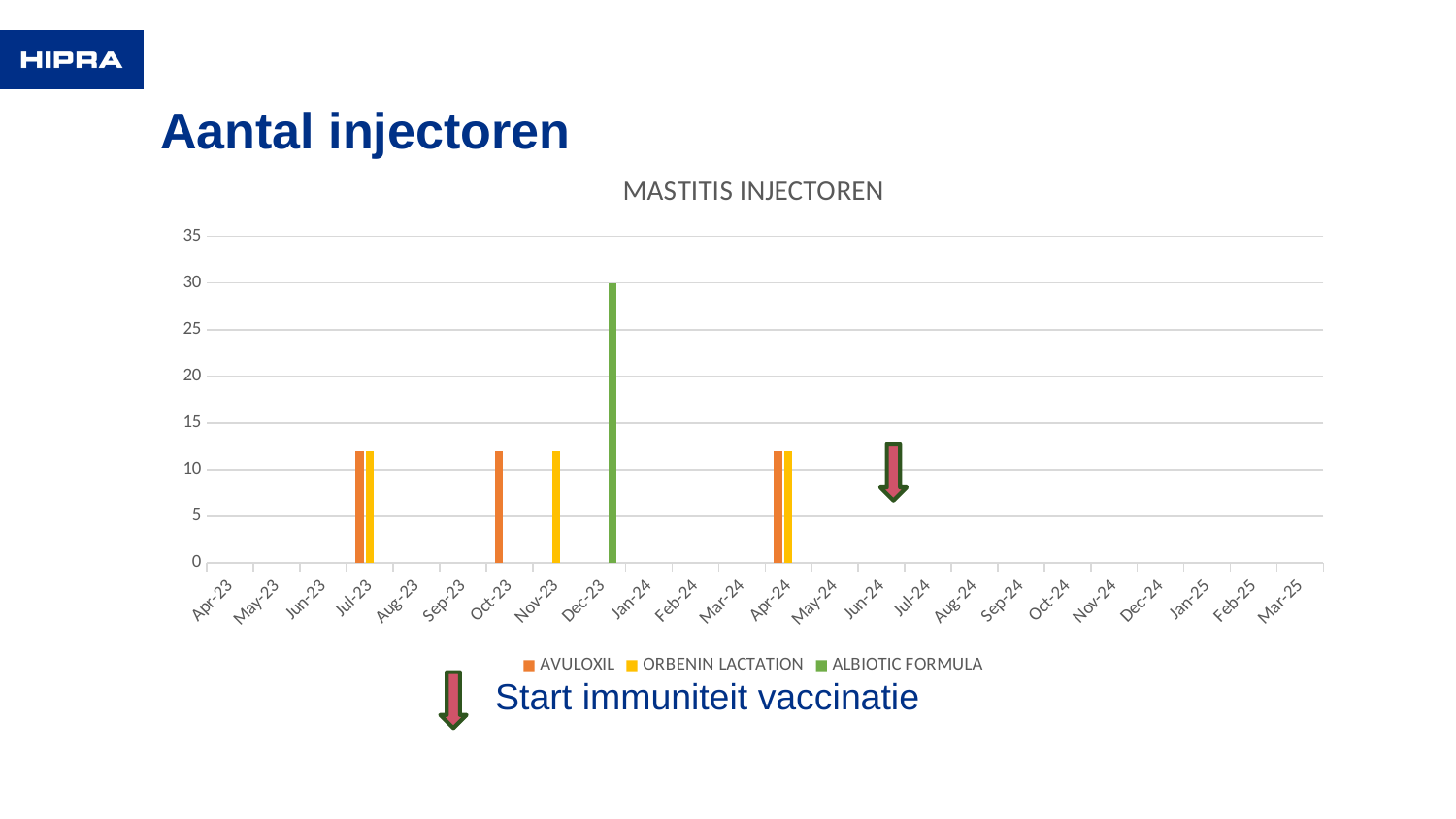
What kind of chart is shown on the slide? bar chart Is the value for ORBENIN LACTATION in Nov-23 greater or less than 15? less Is the value for ALBIOTIC FORMULA in Dec-23 greater or less than 25? greater Which is larger: the ALBIOTIC FORMULA bar in Dec-23 or the AVULOXIL bar in Oct-23? ALBIOTIC FORMULA in Dec-23 Which series has a bar in Dec-23? ALBIOTIC FORMULA What is the value for ALBIOTIC FORMULA in Dec-23? 30 In which month does the MASTITIS INJECTOREN chart show its highest bar? Dec-23 Is the value for AVULOXIL in Jul-23 greater or less than 10? greater What colour represents ALBIOTIC FORMULA in the chart? green How many months are shown on the x axis of the MASTITIS INJECTOREN chart? 24 What is the title of the chart? MASTITIS INJECTOREN How many series does the legend of the MASTITIS INJECTOREN chart list? 3